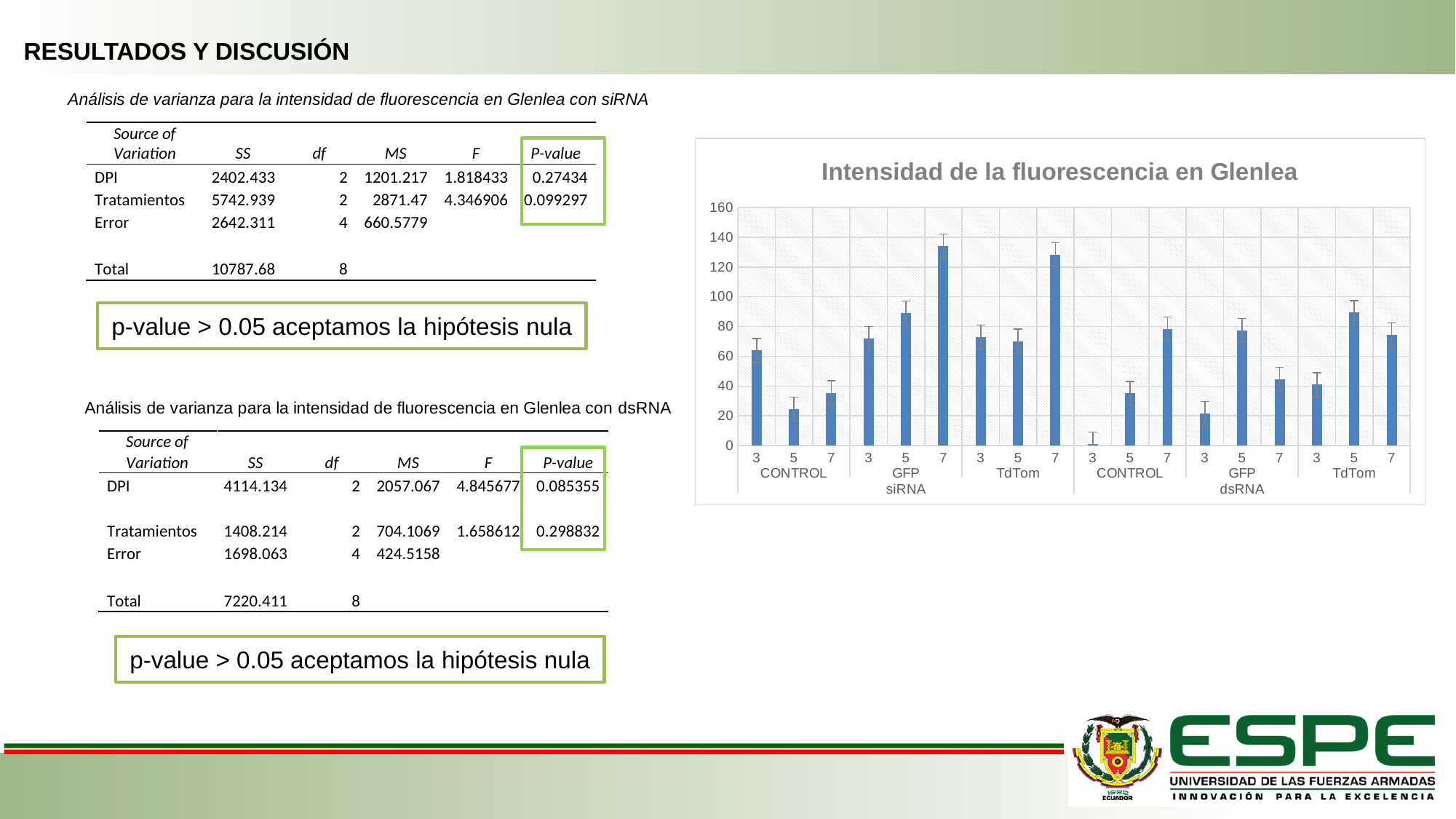
What is the highest value shown on the vertical axis of the chart? 160 How many bars are plotted in the chart? 18 What is the title of the chart? Intensidad de la fluorescencia en Glenlea Is the value for dsRNA GFP at 3 greater or less than 40? less Which is larger, the value for siRNA TdTom at 7 or the value for dsRNA CONTROL at 7? siRNA TdTom at 7 Is the value for siRNA GFP at 7 greater or less than 120? greater Which bar is the highest in the chart? siRNA GFP at 7 Within the siRNA GFP group, do the values rise or fall from 3 to 7? rise Which bar is the lowest in the chart? dsRNA CONTROL at 3 Is the value for siRNA CONTROL at 5 greater or less than 40? less What kind of chart is shown on the slide? bar chart